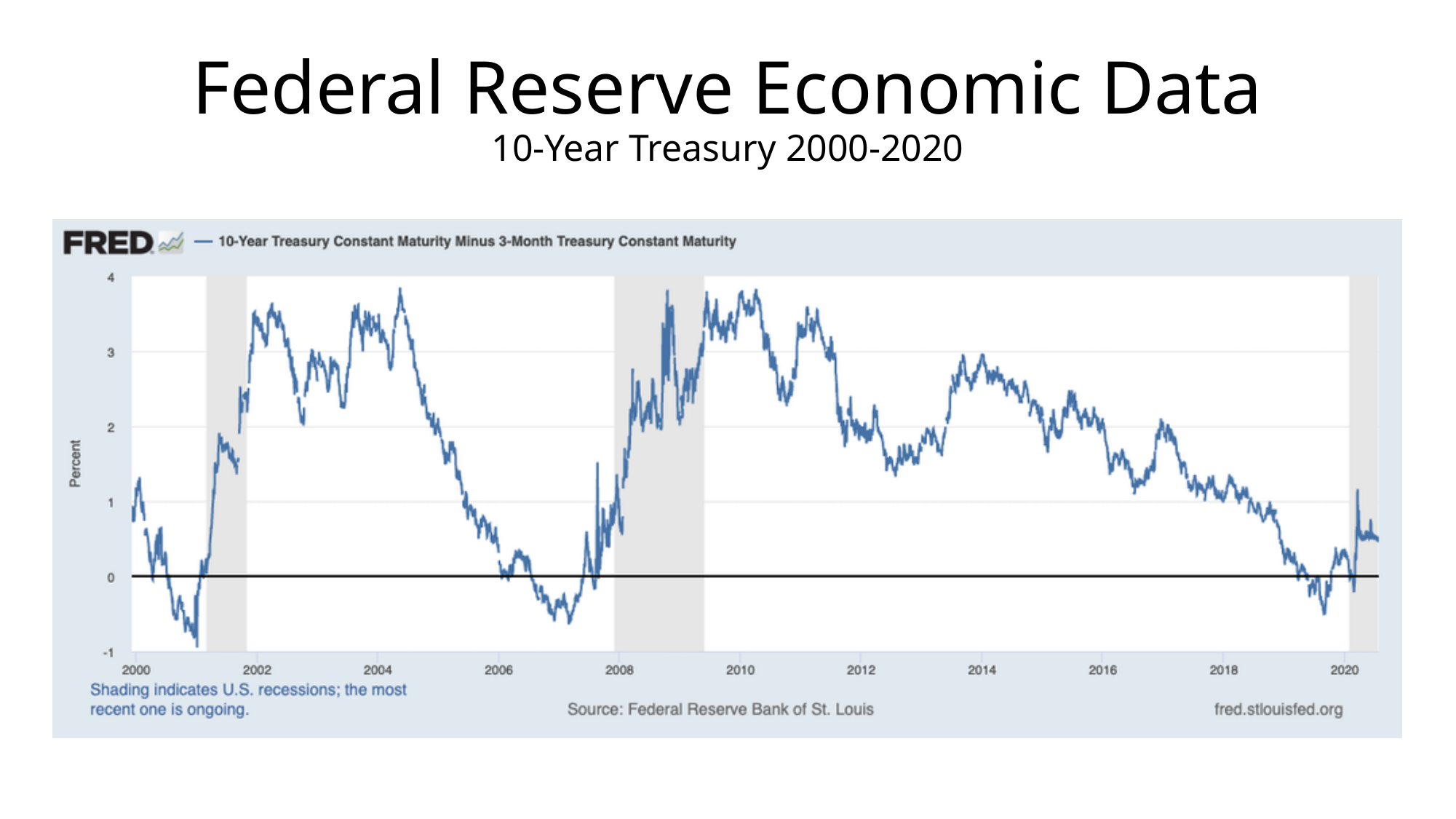
How many series does the chart's legend list? 1 Is the value at the start of 2007 greater or less than 0? less What is the label on the chart's vertical axis? Percent Is the value at the start of 2014 greater or less than 2? greater Does the plotted value generally rise or fall between 2010 and 2019? fall Is the value at the start of 2004 greater or less than 3? greater How many year labels are shown along the x axis? 11 What is the name of the series plotted in the chart? 10-Year Treasury Constant Maturity Minus 3-Month Treasury Constant Maturity What kind of chart is shown on the slide? line chart